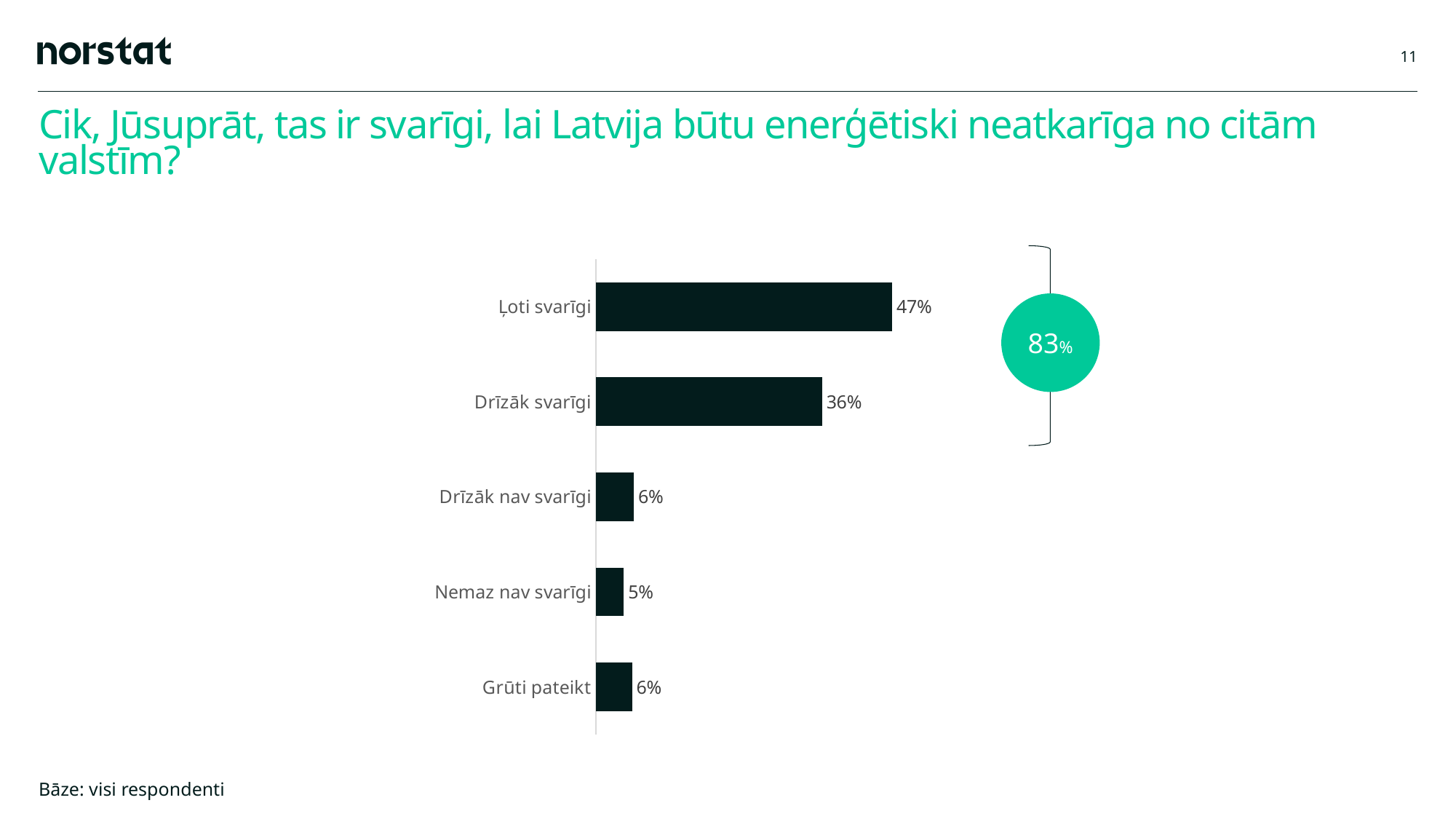
Which category has the highest value? Ļoti svarīgi What is the combined value of "Ļoti svarīgi" and "Drīzāk svarīgi"? 83% What is the difference between the values for "Ļoti svarīgi" and "Drīzāk svarīgi"? 11% Which category has the lowest value? Nemaz nav svarīgi Which is larger, the value for "Drīzāk svarīgi" or the value for "Drīzāk nav svarīgi"? Drīzāk svarīgi What is the value for "Grūti pateikt"? 6% What is the value for "Nemaz nav svarīgi"? 5% What kind of chart is shown on the slide? Bar chart What is the value for "Ļoti svarīgi"? 47% How many categories are shown in the chart? 5 What percentage is shown in the green circle next to the chart? 83% What is the value for "Drīzāk svarīgi"? 36%